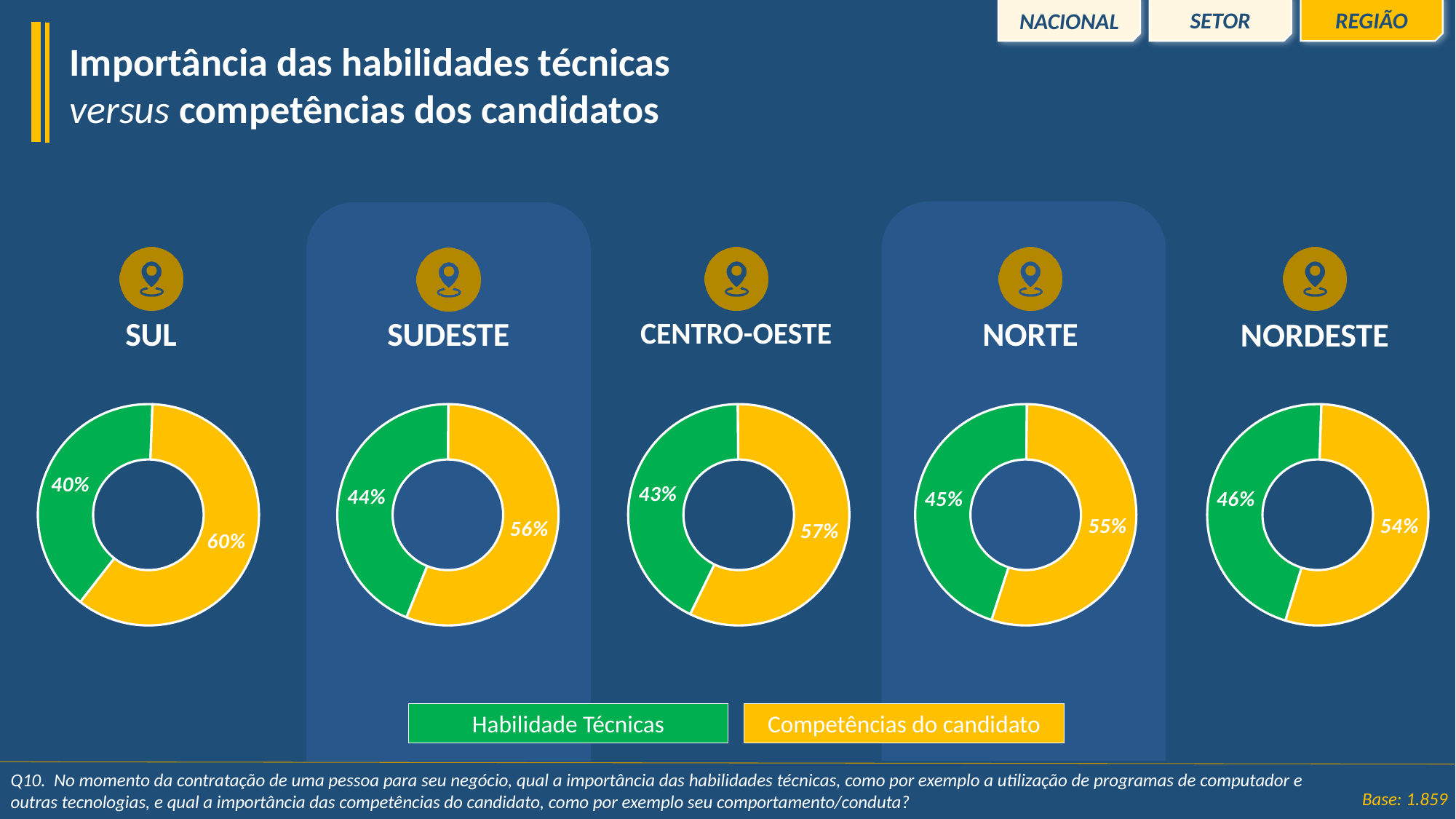
In the SUDESTE chart, what percentage is shown for Competências do candidato? 56% How many regional charts are shown on the slide? 5 In the NORDESTE chart, which is larger: Habilidade Técnicas or Competências do candidato? Competências do candidato In the NORTE chart, what percentage is shown for Competências do candidato? 55% In the NORDESTE chart, what percentage is shown for Habilidade Técnicas? 46% In the SUL chart, what is the difference between Competências do candidato and Habilidade Técnicas? 20 percentage points In the SUL chart, what percentage is shown for Habilidade Técnicas? 40% Across the five regional charts, which region has the lowest value for Habilidade Técnicas? SUL Across the five regional charts, which region has the highest value for Competências do candidato? SUL How many entries does the legend at the bottom of the slide list? 2 What kind of chart is used for each region on the slide? Donut chart In the CENTRO-OESTE chart, what percentage is shown for Habilidade Técnicas? 43%